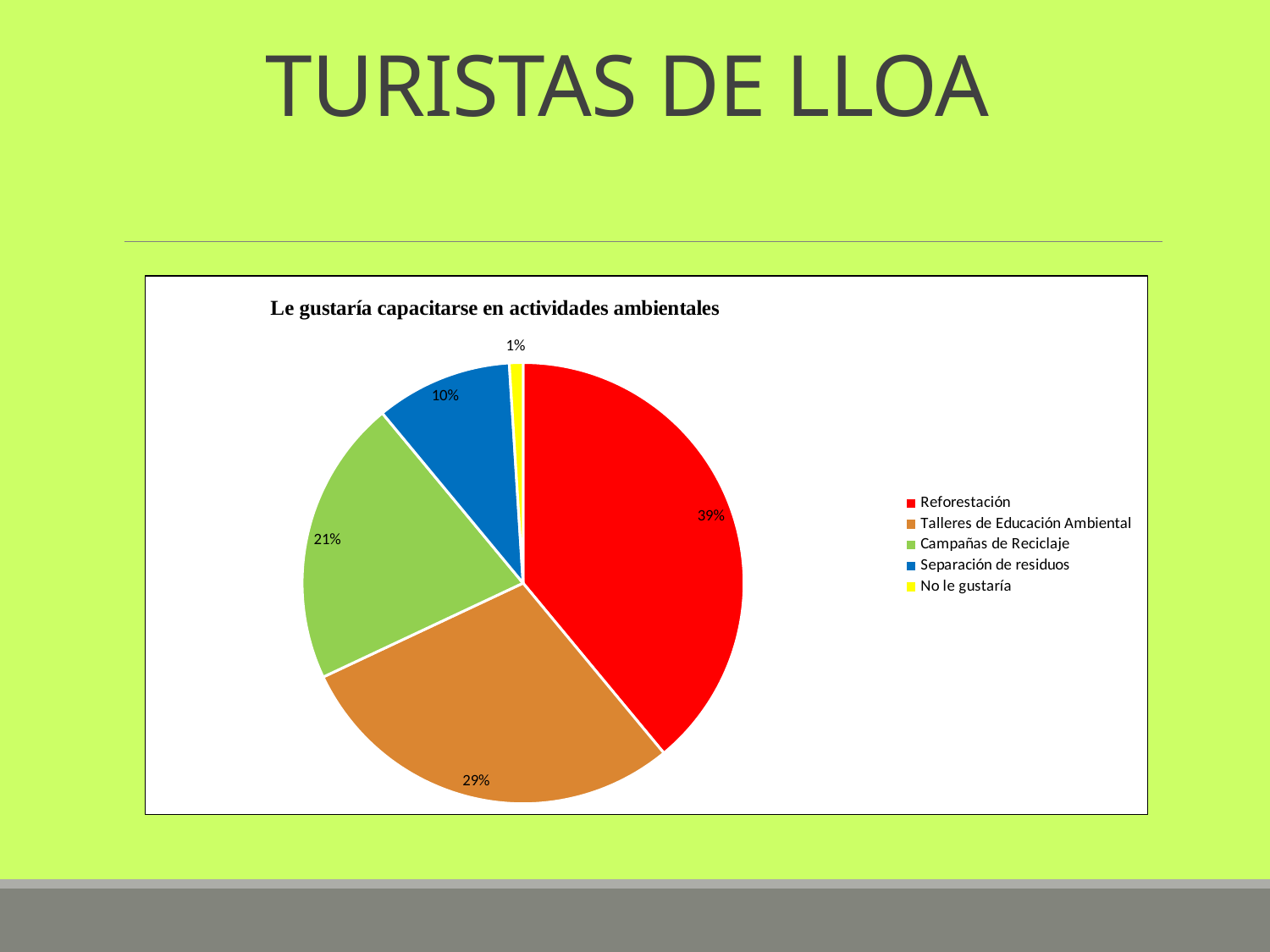
Which is larger, the share for Campañas de Reciclaje or the share for Separación de residuos? Campañas de Reciclaje What percentage of the pie does Talleres de Educación Ambiental represent? 29% What type of chart is shown on the slide? Pie chart Which category has the largest share of the pie? Reforestación What percentage of the pie does Campañas de Reciclaje represent? 21% Which category has the smallest share of the pie? No le gustaría What percentage of the pie does Reforestación represent? 39% What percentage of the pie does No le gustaría represent? 1% What percentage of the pie does Separación de residuos represent? 10% How many categories does the legend list? 5 What is the difference in percentage points between Reforestación and Talleres de Educación Ambiental? 10 What is the title of the chart? Le gustaría capacitarse en actividades ambientales